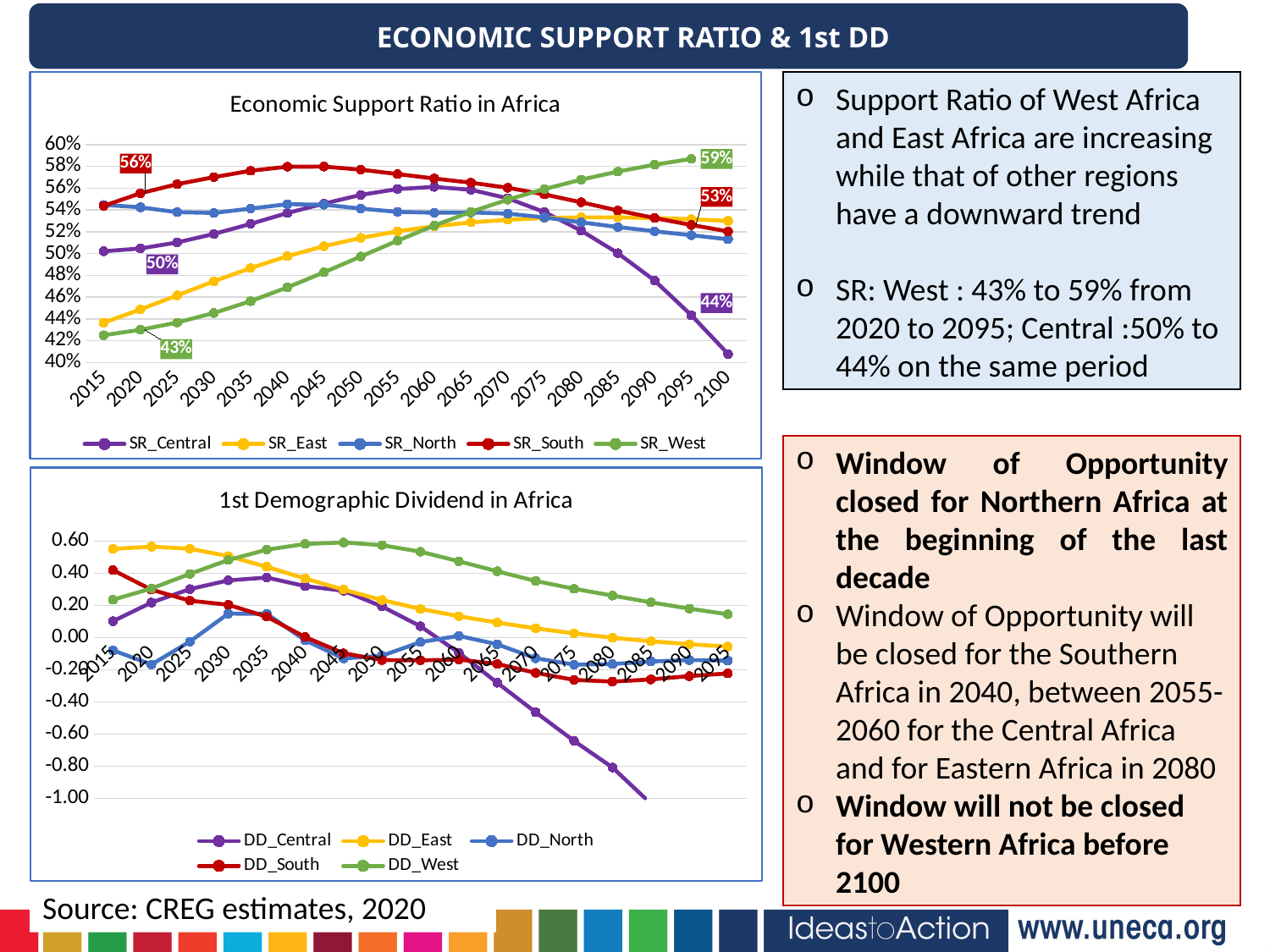
In the 'Economic Support Ratio in Africa' chart, which series has the lowest value in 2100? SR_Central In the 'Economic Support Ratio in Africa' chart, by how many percentage points does the labelled SR_West value in 2095 exceed its labelled value in 2020? 16 percentage points In the 'Economic Support Ratio in Africa' chart, what is the labelled value for SR_West in 2095? 59% In the 'Economic Support Ratio in Africa' chart, which series has the highest value in 2095? SR_West In the 'Economic Support Ratio in Africa' chart, what is the labelled value for SR_South in 2020? 56% How many series does the legend of the 'Economic Support Ratio in Africa' chart list? 5 In the 'Economic Support Ratio in Africa' chart, what is the labelled value for SR_West in 2020? 43% In the 'Economic Support Ratio in Africa' chart, what is the labelled value for SR_Central in 2095? 44% In the '1st Demographic Dividend in Africa' chart, is the value for DD_Central in 2080 greater or less than -0.40? less In the '1st Demographic Dividend in Africa' chart, is the value for DD_West in 2045 greater or less than 0.40? greater What kind of chart is the 'Economic Support Ratio in Africa' chart? Line chart In the 'Economic Support Ratio in Africa' chart, does the SR_West line rise or fall from 2015 to 2095? Rise